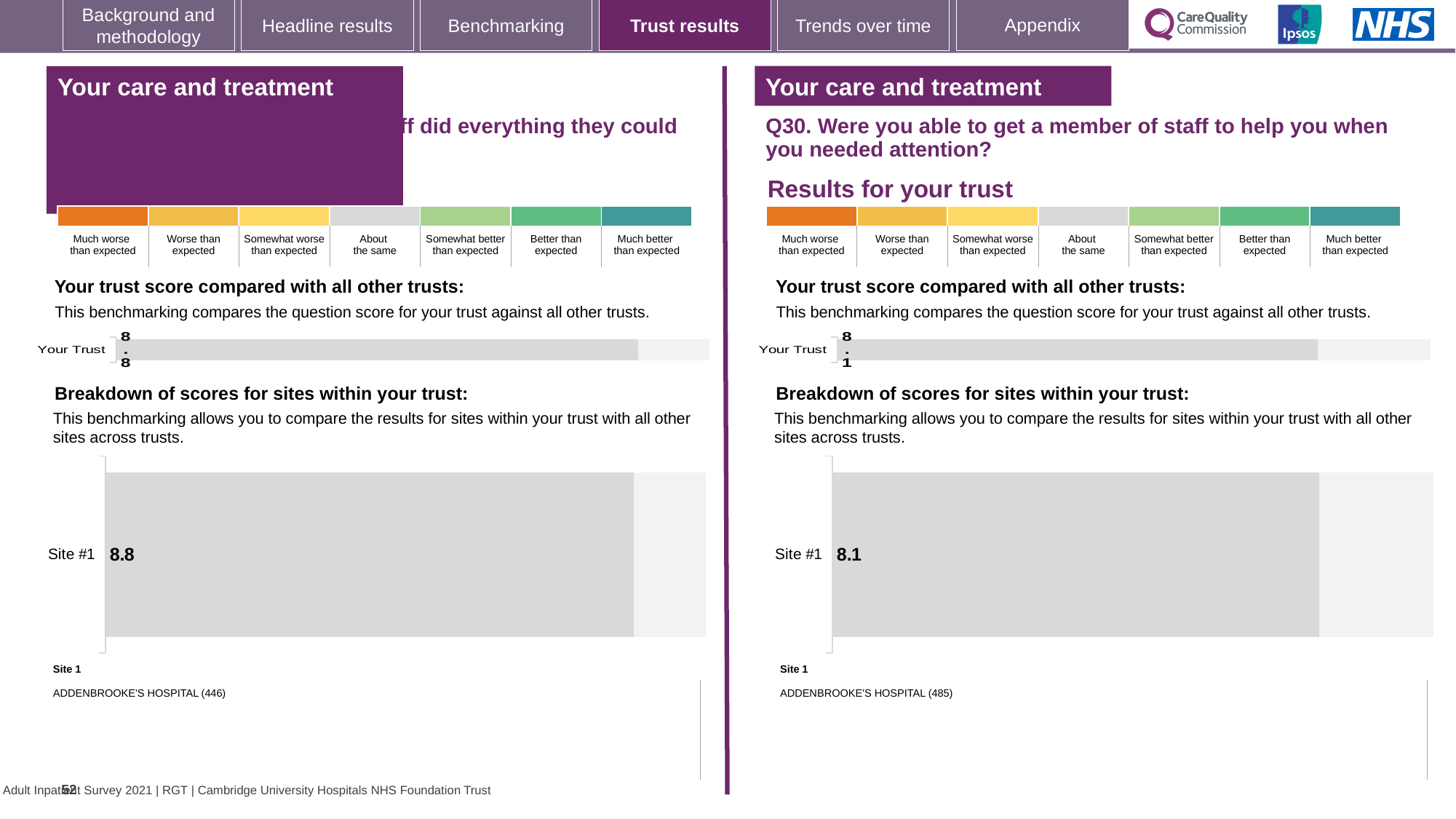
How many sites are shown in the 'Breakdown of scores for sites within your trust' chart on the right-hand panel (Q30)? 1 On the right-hand panel (Q30), what is the score shown for Your Trust in the 'Your trust score compared with all other trusts' chart? 8.1 How many sites are shown in the 'Breakdown of scores for sites within your trust' chart on the left-hand panel? 1 Which panel shows the higher Site #1 score, the left-hand panel or the right-hand panel (Q30)? the left-hand panel What is the difference between the Site #1 score on the left-hand panel and the Site #1 score on the right-hand panel (Q30)? 0.7 Which panel shows the higher Your Trust score, the left-hand panel or the right-hand panel (Q30)? the left-hand panel What type of chart is used to show the Site #1 score on the right-hand panel (Q30)? bar chart On the left-hand panel, what is the score shown for Your Trust in the 'Your trust score compared with all other trusts' chart? 8.8 On the right-hand panel (Q30), what score is shown for Site #1 in the 'Breakdown of scores for sites within your trust' chart? 8.1 On the left-hand panel, what score is shown for Site #1 in the 'Breakdown of scores for sites within your trust' chart? 8.8 On the right-hand panel (Q30), which site name is listed as Site 1 below the chart? ADDENBROOKE'S HOSPITAL (485) On the left-hand panel, which site name is listed as Site 1 below the chart? ADDENBROOKE'S HOSPITAL (446)